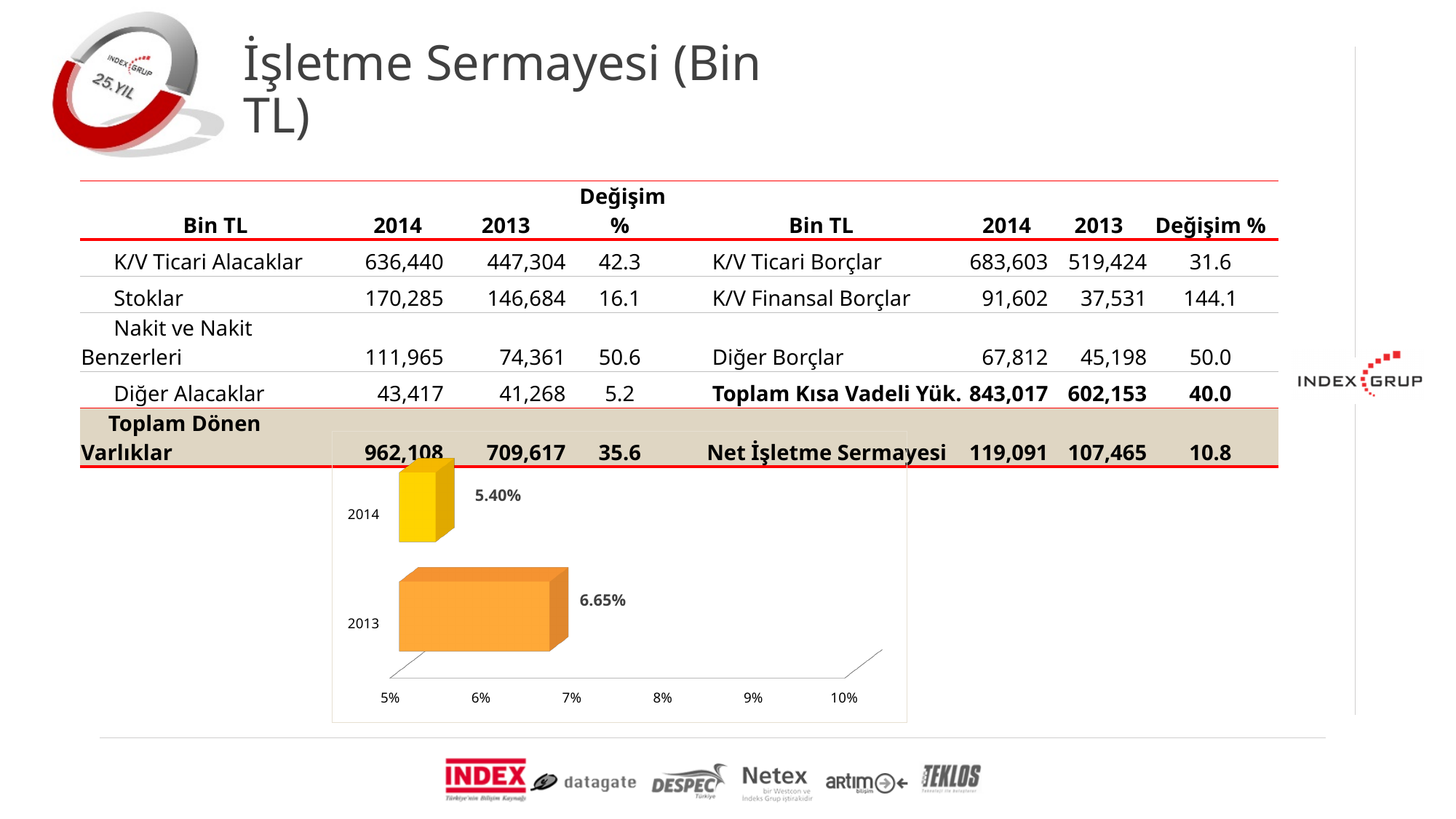
What colour is the 2014 bar in the chart? yellow Is the value for 2014 in the bar chart larger or smaller than the value for 2013? smaller Which year has the lower value in the bar chart? 2014 What is the difference between the 2013 and 2014 values in the bar chart? 1.25% Is the value for 2013 in the bar chart greater or less than 7%? less Is the value for 2014 in the bar chart greater or less than 6%? less Which year has the higher value in the bar chart? 2013 Did the value rise or fall from 2013 to 2014 in the bar chart? fall How many bars are plotted in the chart? 2 What is the value shown for 2014 in the bar chart? 5.40% What is the value shown for 2013 in the bar chart? 6.65% What kind of chart is shown on the slide? bar chart